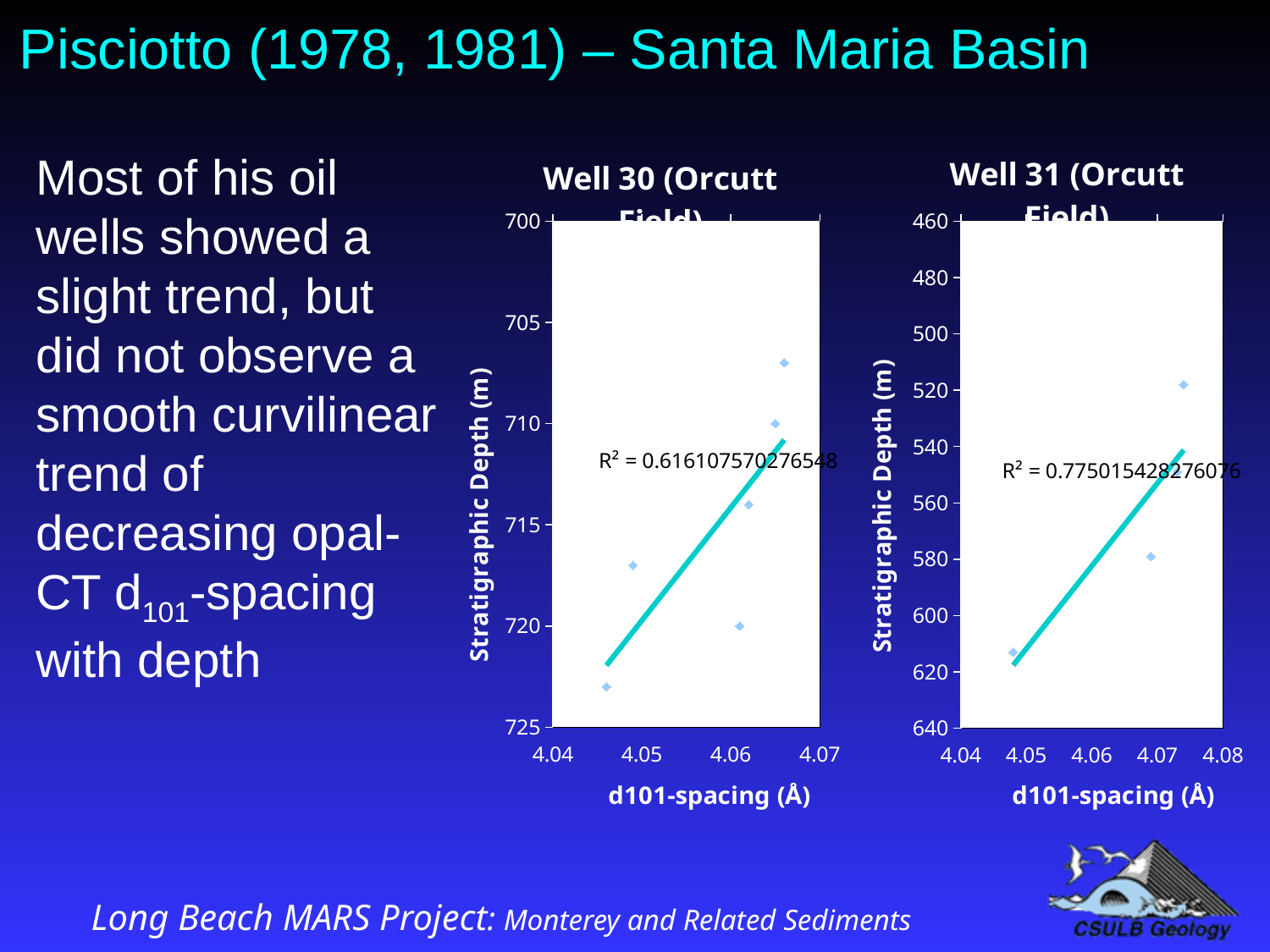
In the Well 31 (Orcutt Field) chart, is the stratigraphic depth of the point with the largest d101-spacing greater or less than 540? less In the Well 30 (Orcutt Field) chart, is the stratigraphic depth of the point with the smallest d101-spacing greater or less than 720? greater What R² value is printed on the Well 31 (Orcutt Field) chart? 0.775015428276076 Which chart shows the higher R² value, Well 30 (Orcutt Field) or Well 31 (Orcutt Field)? Well 31 (Orcutt Field) What R² value is printed on the Well 30 (Orcutt Field) chart? 0.616107570276548 What is the y-axis title of the Well 31 (Orcutt Field) chart? Stratigraphic Depth (m) What kind of chart is the Well 30 (Orcutt Field) chart? Scatter chart What is the x-axis title of the Well 30 (Orcutt Field) chart? d101-spacing (Å) In the Well 31 (Orcutt Field) chart, does stratigraphic depth increase or decrease as d101-spacing increases? decrease How many data points are plotted in the Well 30 (Orcutt Field) chart? 6 How many charts are shown on the slide? 2